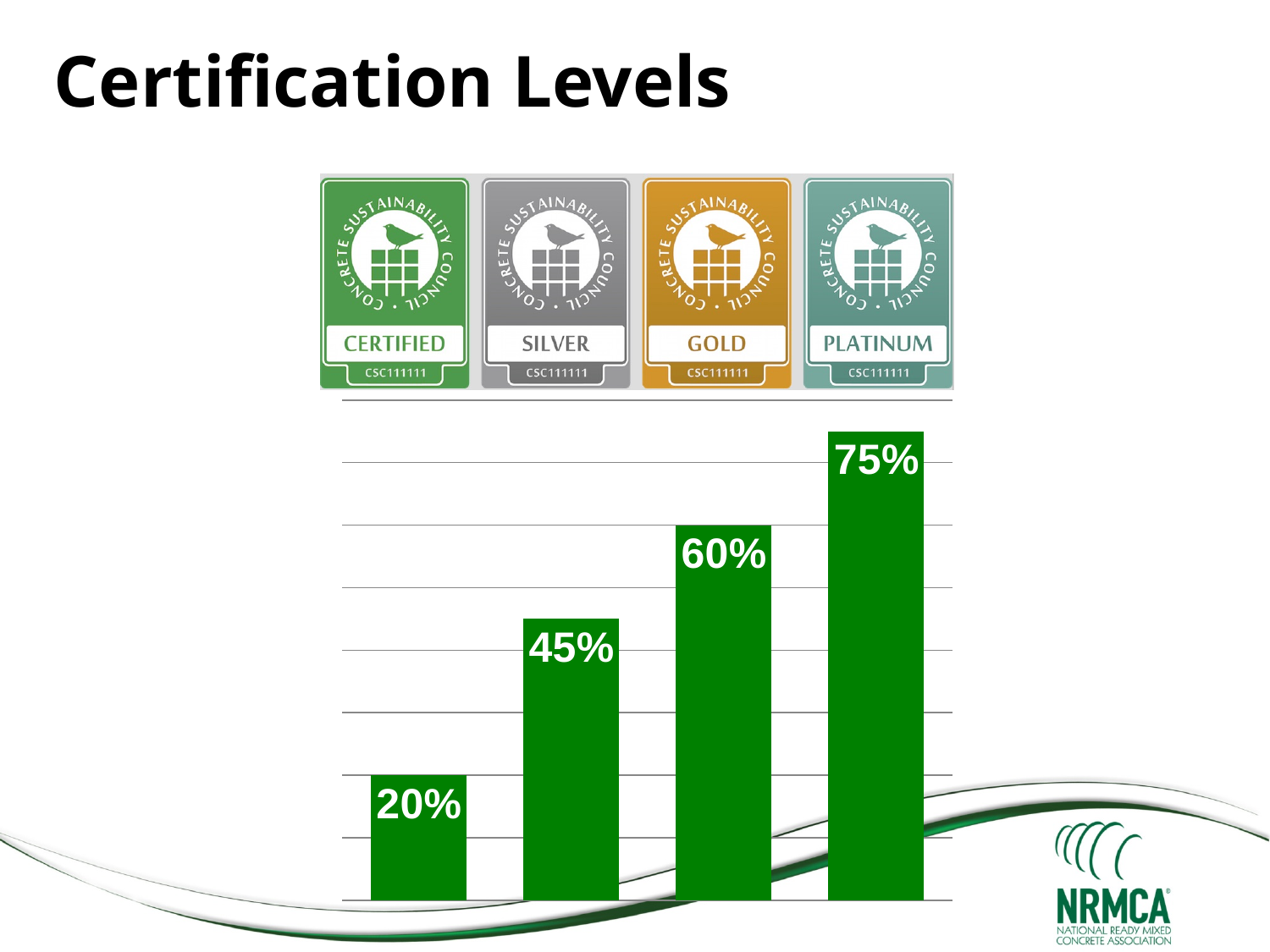
What value is shown for the Platinum level (fourth bar)? 75% How many bars are plotted in the chart? 4 Which is larger, the value for Silver or the value for Gold? Gold What kind of chart is shown on the slide? Bar chart What value is shown for the Gold level (third bar)? 60% Do the bar values rise or fall from left to right? Rise What value is shown for the Silver level (second bar)? 45% Which certification level has the lowest bar? Certified What is the difference between the Platinum value and the Certified value? 55% What value is shown for the Certified level (first bar)? 20% Which certification level has the highest bar? Platinum What is the difference between the Gold value and the Silver value? 15%